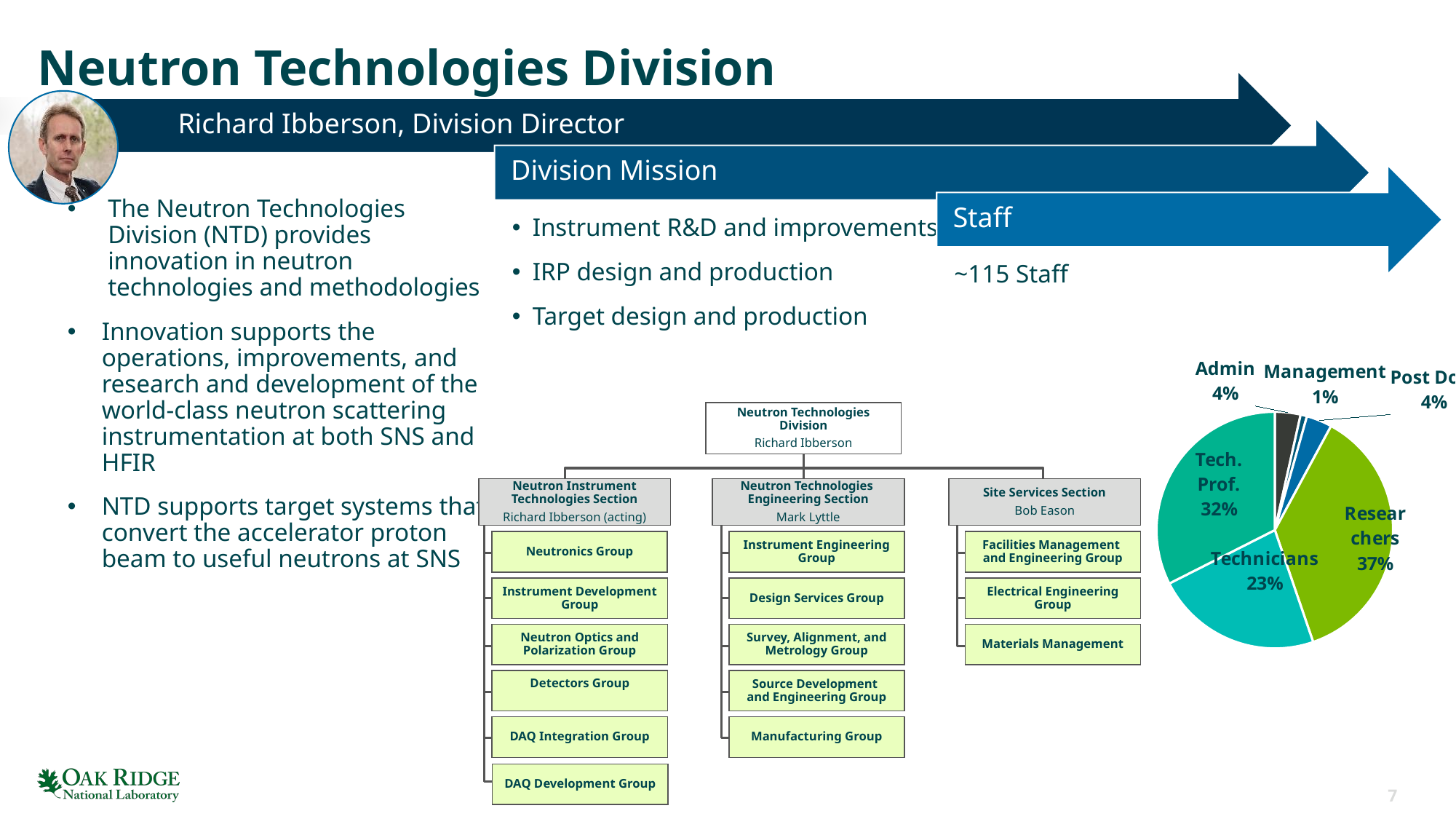
In the pie chart, what is the combined share of Researchers and Tech. Prof.? 69% Which category has the largest slice in the pie chart? Researchers In the pie chart, what share of staff are Management? 1% In the pie chart, what is the difference between the Researchers share and the Technicians share? 14 percentage points In the pie chart, what share of staff are Technicians? 23% What kind of chart is shown on the right side of the slide? pie chart In the pie chart, which is larger: Tech. Prof. or Technicians? Tech. Prof. In the pie chart, what share of staff are Tech. Prof.? 32% How many slices does the pie chart have? 6 In the pie chart, what share of staff are Researchers? 37% Which category has the smallest slice in the pie chart? Management In the pie chart, what share of staff are Admin? 4%